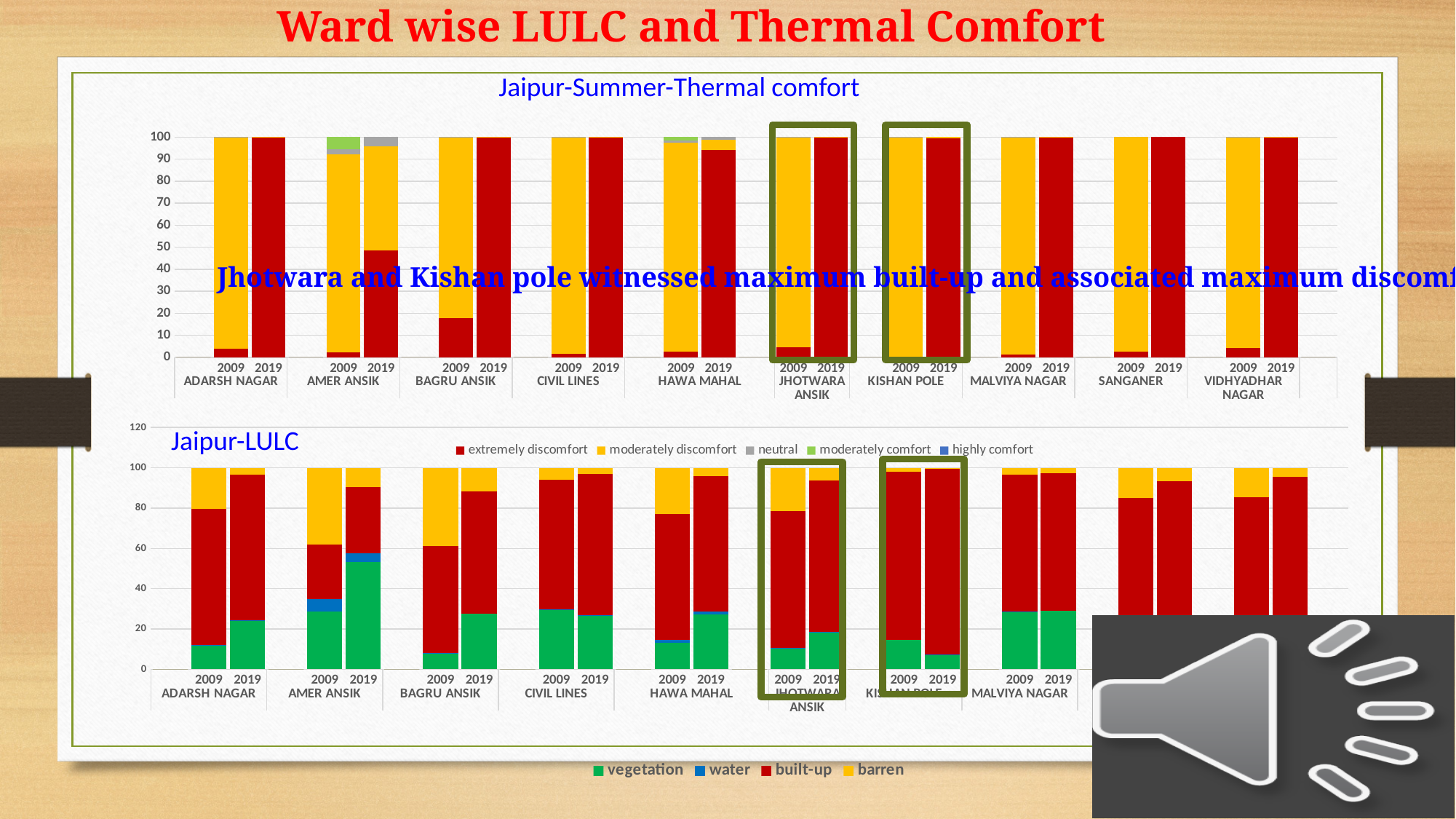
In the Jaipur-Summer-Thermal comfort chart, is the extremely discomfort value for Amer Ansik in 2009 greater or less than 10? less How many wards are shown on the x axis of the Jaipur-Summer-Thermal comfort chart? 10 In the Jaipur-Summer-Thermal comfort chart, is the extremely discomfort value for Bagru Ansik in 2009 greater or less than 20? less How many series does the legend of the Jaipur-LULC chart list? 4 In the Jaipur-LULC chart, does the vegetation value for Amer Ansik rise or fall from 2009 to 2019? rise In the Jaipur-LULC chart, is the vegetation value for Amer Ansik in 2019 greater or less than 40? greater Which two wards are highlighted with green boxes on both charts? Jhotwara Ansik and Kishan Pole What kind of chart is the Jaipur-Summer-Thermal comfort chart? stacked bar chart In the Jaipur-LULC chart, which colour represents built-up? red How many series does the legend of the Jaipur-Summer-Thermal comfort chart list? 5 In the Jaipur-Summer-Thermal comfort chart, which is larger for Bagru Ansik: the extremely discomfort value in 2009 or in 2019? 2019